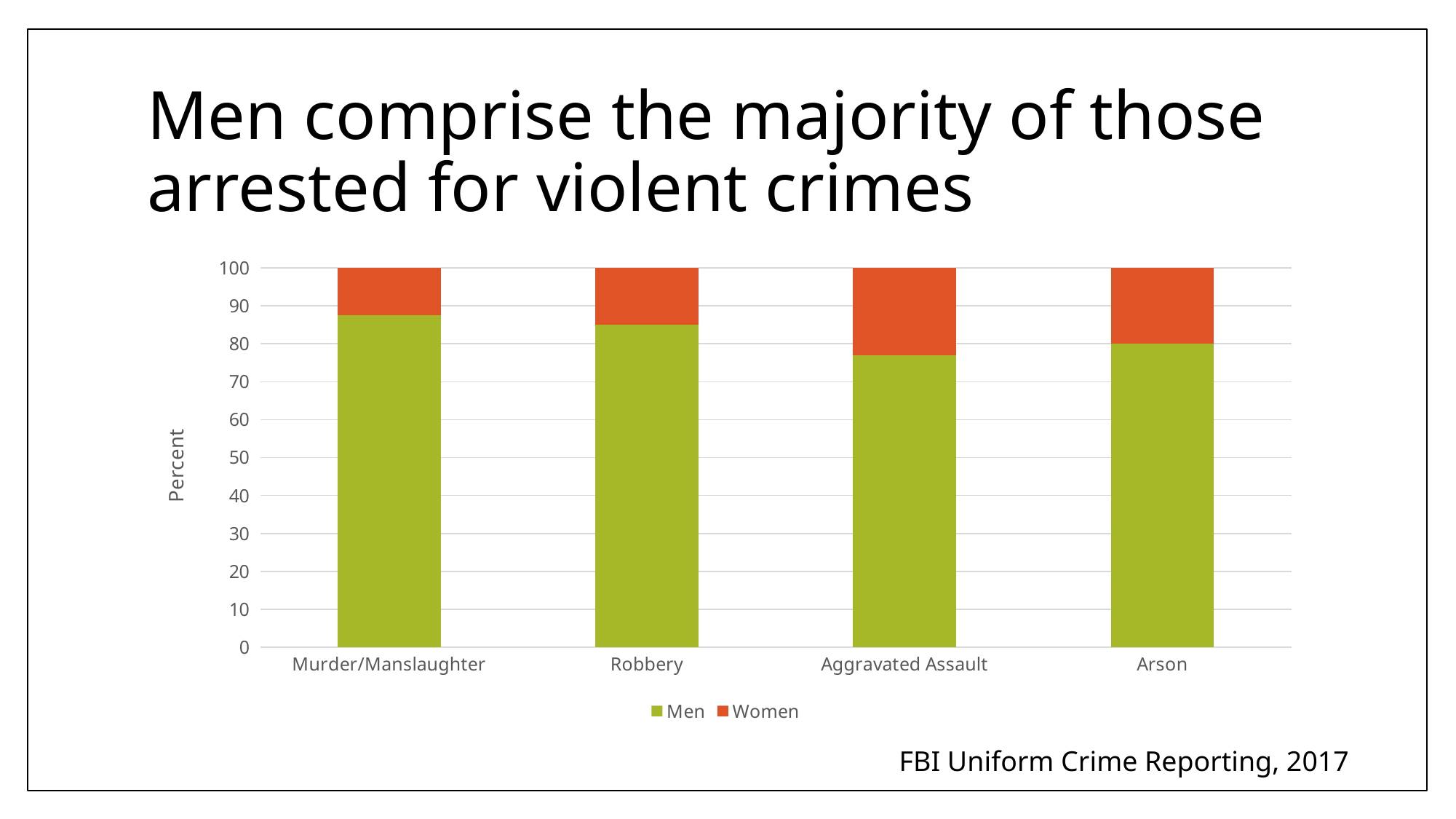
How many series does the legend list? 2 Is the value for Men in Aggravated Assault greater or less than 80? less How many crime categories are shown on the x axis? 4 Which crime category has the highest share of Women? Aggravated Assault Which crime category has the lowest share of Men? Aggravated Assault Which is larger, the Men share for Robbery or the Men share for Arson? Robbery What is the label on the y axis? Percent Is the value for Women in Murder/Manslaughter greater or less than 20? less What kind of chart is shown on the slide? bar chart Is the value for Men in Murder/Manslaughter greater or less than 80? greater What is the total of the stacked bar for Robbery? 100 What colour represents Women in the chart? orange-red